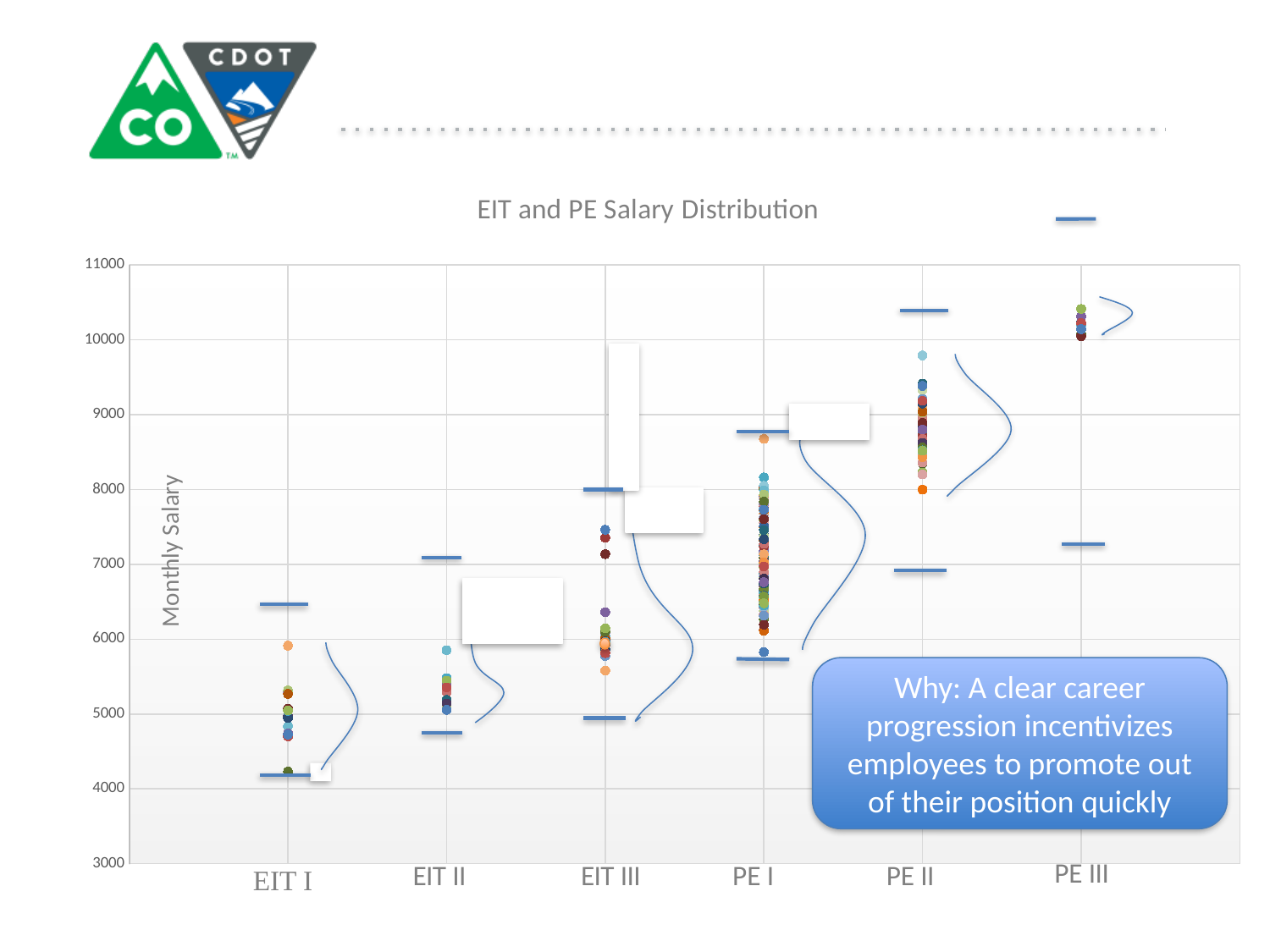
Are the plotted salaries for PE III greater or less than 9000? greater Do the plotted salaries generally rise or fall moving from EIT I to PE III along the x axis? Rise Which position category has the highest plotted salaries? PE III What is the label of the vertical axis? Monthly Salary Which category has higher plotted salaries, PE III or EIT I? PE III Which position category has the lowest plotted salaries? EIT I What kind of chart is shown on the slide? Scatter (dot) chart How many position categories are shown along the x axis? 6 Are the plotted salaries for PE II greater or less than 7000? greater Are the plotted salaries for EIT III greater or less than 8000? less What is the title of the chart? EIT and PE Salary Distribution